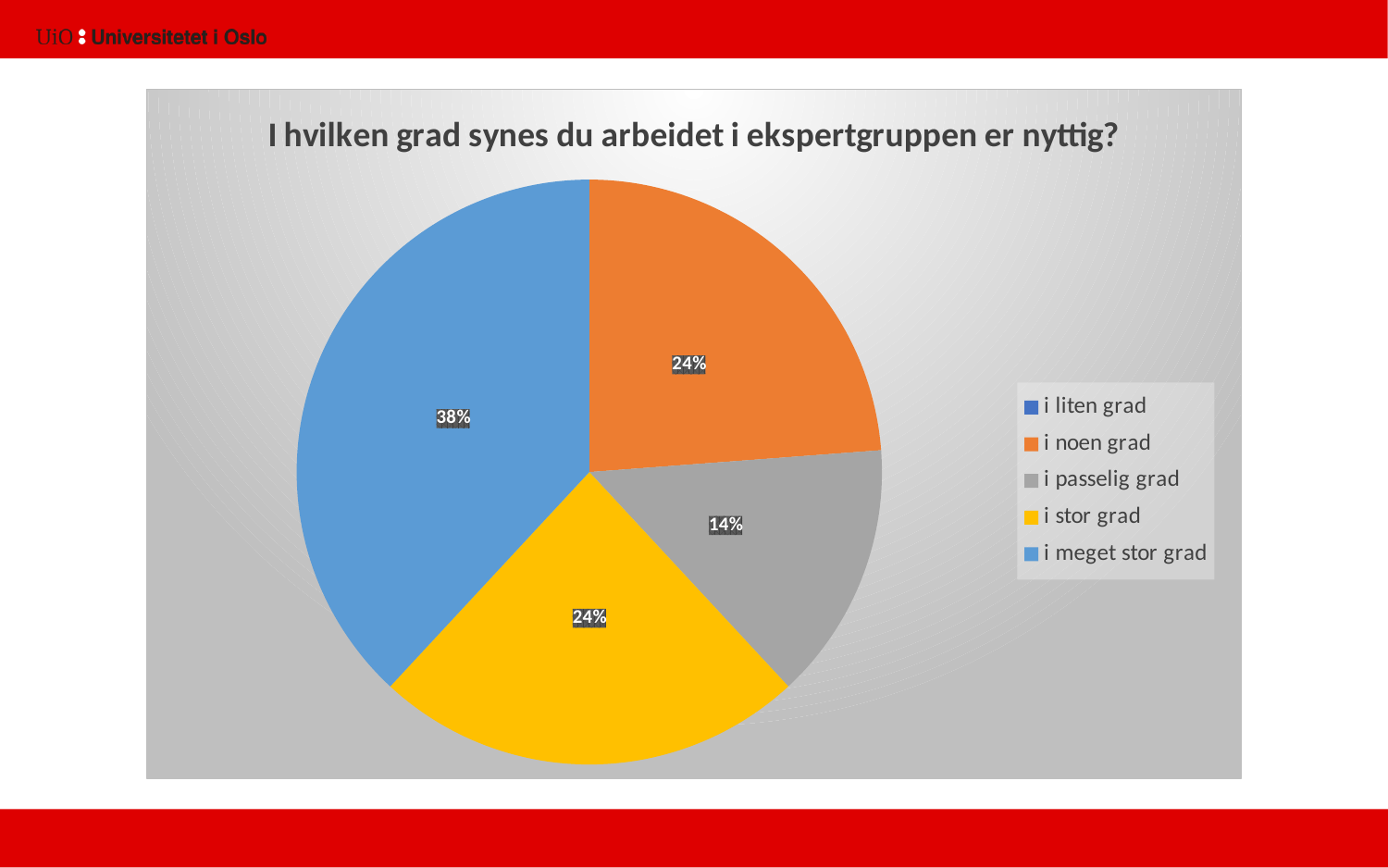
How many percentage points larger is the "i meget stor grad" slice than the "i passelig grad" slice? 24 What colour is the slice for "i stor grad"? yellow What percentage of the pie is labelled for "i passelig grad"? 14% What is the title of the chart? I hvilken grad synes du arbeidet i ekspertgruppen er nyttig? Which slice is larger, "i meget stor grad" or "i noen grad"? i meget stor grad How many entries does the legend list? 5 What percentage of the pie is labelled for "i stor grad"? 24% Which of the labelled slices is the smallest? i passelig grad Which category has the largest slice of the pie? i meget stor grad What percentage of the pie is labelled for "i noen grad"? 24% What kind of chart is shown on the slide? pie chart What percentage of the pie is labelled for "i meget stor grad"? 38%